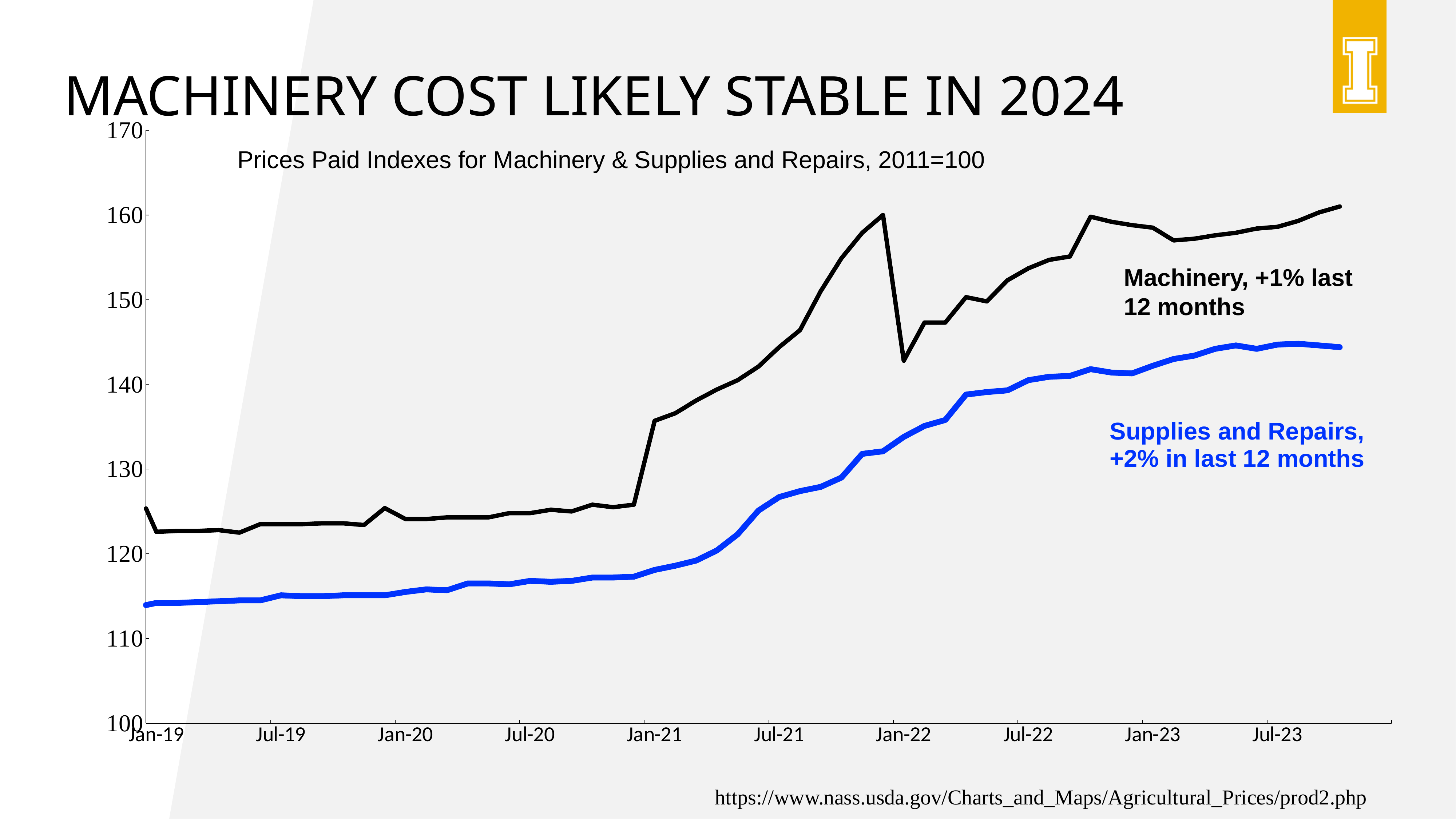
Is the Machinery value at Jan-19 greater or less than 120? greater Which series stays above the other across the whole period shown? Machinery Is the Supplies and Repairs value at Jul-23 greater or less than 140? greater Does the Supplies and Repairs line generally rise or fall from Jan-19 to Jul-23? rise Is the Supplies and Repairs value at Jan-19 greater or less than 120? less How many series are plotted on the chart? 2 What is the subtitle printed above the chart? Prices Paid Indexes for Machinery & Supplies and Repairs, 2011=100 According to the annotation, by how much did Supplies and Repairs change in the last 12 months? +2% What kind of chart is shown on the slide? line chart Which series is higher at Jan-22, Machinery or Supplies and Repairs? Machinery